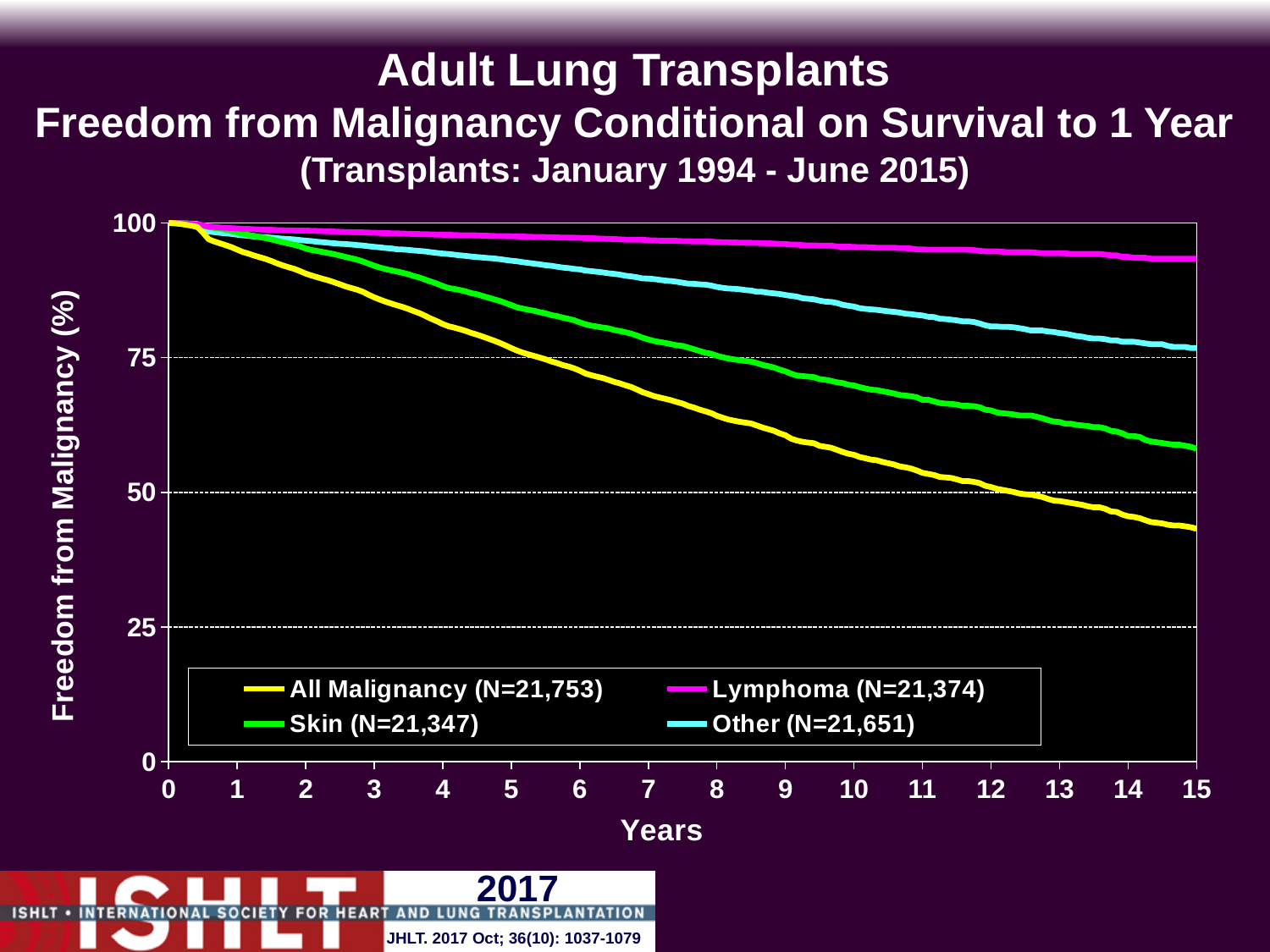
At 10 years, is the value for Skin greater or less than 75? less Which series has the lowest freedom from malignancy at 15 years? All Malignancy At 15 years, is the value for All Malignancy greater or less than 50? less What is the label of the y axis? Freedom from Malignancy (%) At 10 years, is the value for Other greater or less than 75? greater How many series does the legend list? 4 What kind of chart is shown on the slide? Line chart Which series has the highest freedom from malignancy at 15 years? Lymphoma At 15 years, which is larger: the value for Lymphoma or the value for Skin? Lymphoma Do the values for All Malignancy rise or fall as the years increase? Fall What is the N shown in the legend for All Malignancy? N=21,753